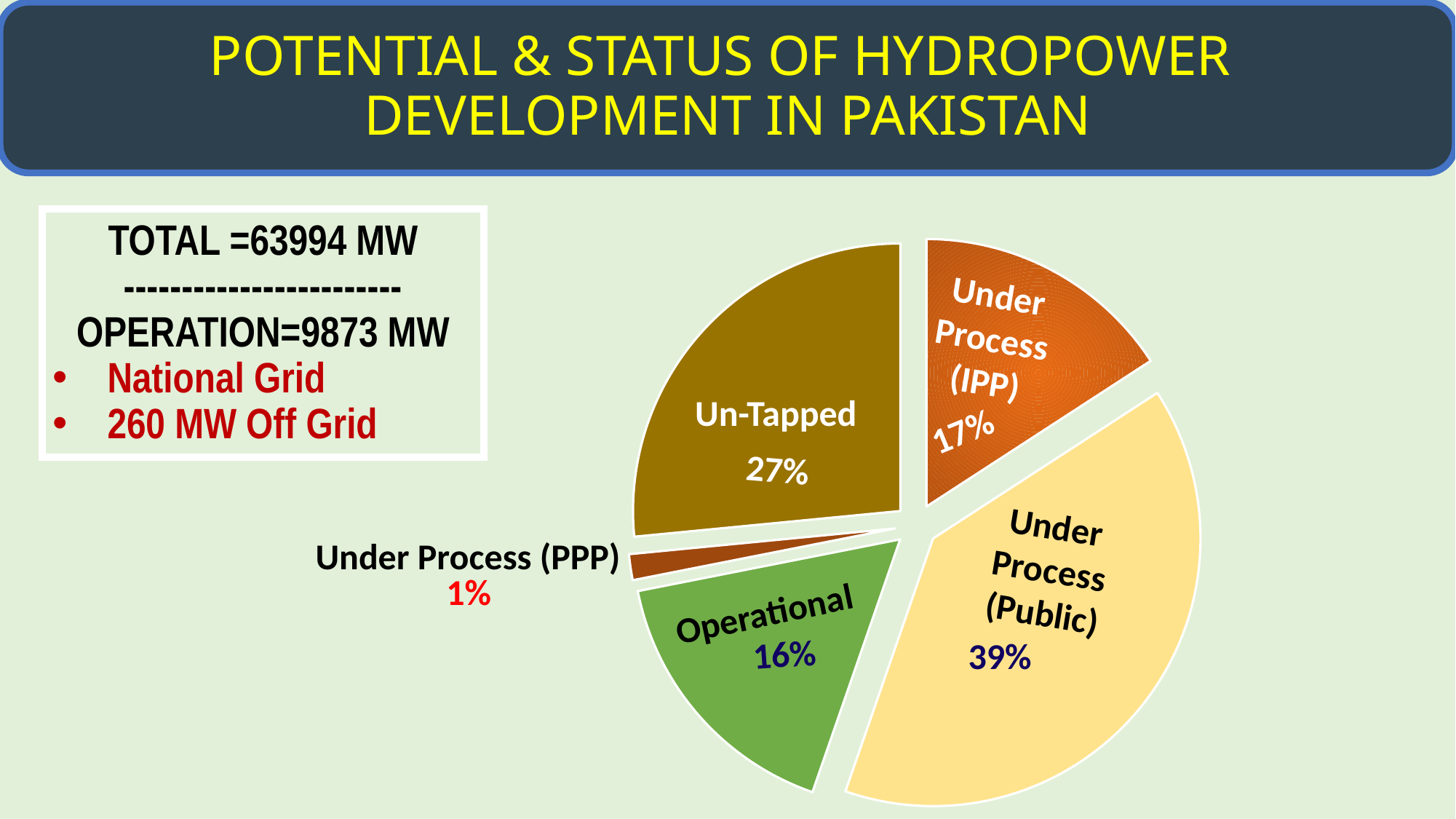
What share of the pie is Un-Tapped? 27% What share of the pie is Under Process (Public)? 39% What share of the pie is Operational? 16% Which slice of the pie is the largest? Under Process (Public) What is the difference in percentage points between Under Process (Public) and Un-Tapped? 12 What is the title of the slide containing the pie chart? POTENTIAL & STATUS OF HYDROPOWER DEVELOPMENT IN PAKISTAN Which is larger, the Un-Tapped slice or the Operational slice? Un-Tapped What kind of chart is shown on the slide? pie chart Which slice of the pie is the smallest? Under Process (PPP) How many slices does the pie chart have? 5